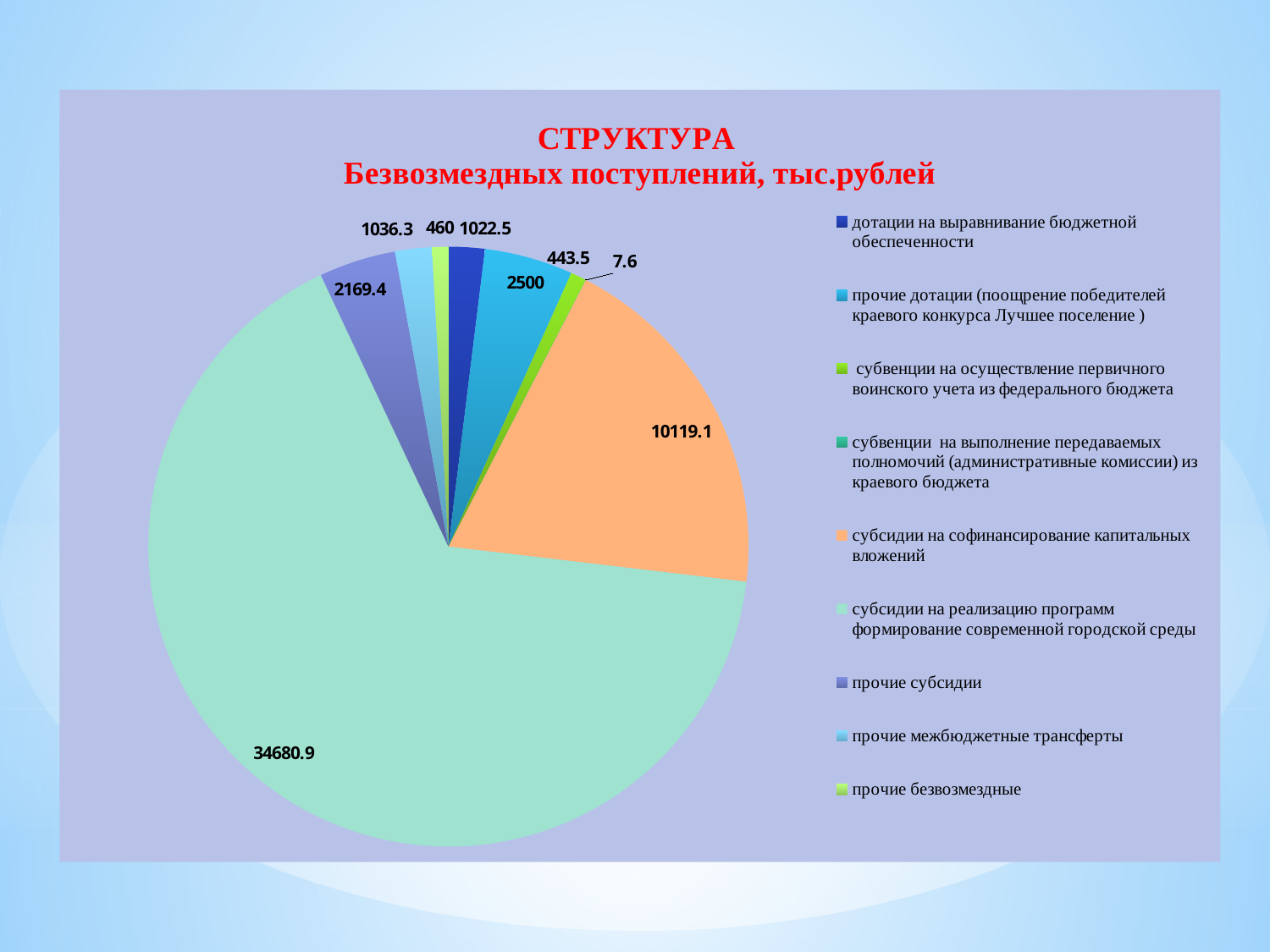
What kind of chart is shown on the slide? pie chart What is the value for прочие дотации (поощрение победителей краевого конкурса Лучшее поселение)? 2500 What unit is stated in the chart title? тыс.рублей Which is larger: прочие субсидии or прочие межбюджетные трансферты? прочие субсидии What is the value for прочие субсидии? 2169.4 Which category has the smallest slice of the pie? субвенции на выполнение передаваемых полномочий (административные комиссии) из краевого бюджета What is the value for субсидии на реализацию программ формирование современной городской среды? 34680.9 What is the difference between субсидии на софинансирование капитальных вложений and прочие дотации? 7619.1 What is the value for субсидии на софинансирование капитальных вложений? 10119.1 How many categories does the legend list? 9 What is the value for субвенции на выполнение передаваемых полномочий (административные комиссии) из краевого бюджета? 7.6 Which category has the largest slice of the pie? субсидии на реализацию программ формирование современной городской среды